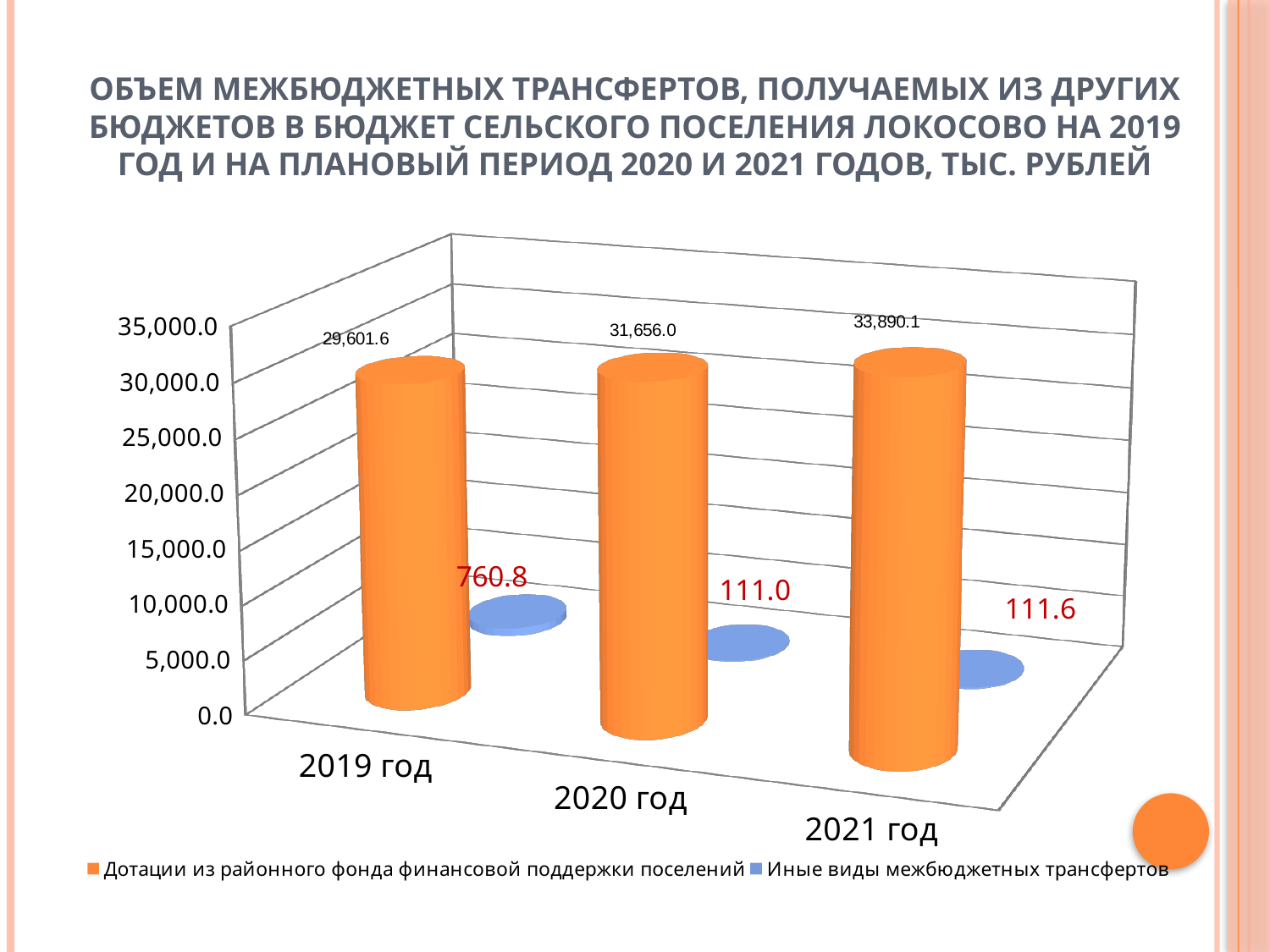
Which is larger: the Дотации value for 2021 год or for 2020 год? 2021 год What is the difference between the Иные виды межбюджетных трансфертов values for 2019 год and 2020 год? 649.8 What is the value of Дотации из районного фонда финансовой поддержки поселений for 2019 год? 29,601.6 Does the value of Дотации из районного фонда финансовой поддержки поселений rise or fall from 2019 год to 2021 год? rise What is the difference between the Дотации values for 2020 год and 2019 год? 2,054.4 In which year is the value of Дотации из районного фонда финансовой поддержки поселений the highest? 2021 год Is the Дотации value for 2019 год greater or less than 30,000.0? less What is the value of Иные виды межбюджетных трансфертов for 2019 год? 760.8 What is the value of Дотации из районного фонда финансовой поддержки поселений for 2021 год? 33,890.1 What is the value of Иные виды межбюджетных трансфертов for 2020 год? 111.0 How many series does the legend list? 2 In which year is the value of Иные виды межбюджетных трансфертов the lowest? 2020 год